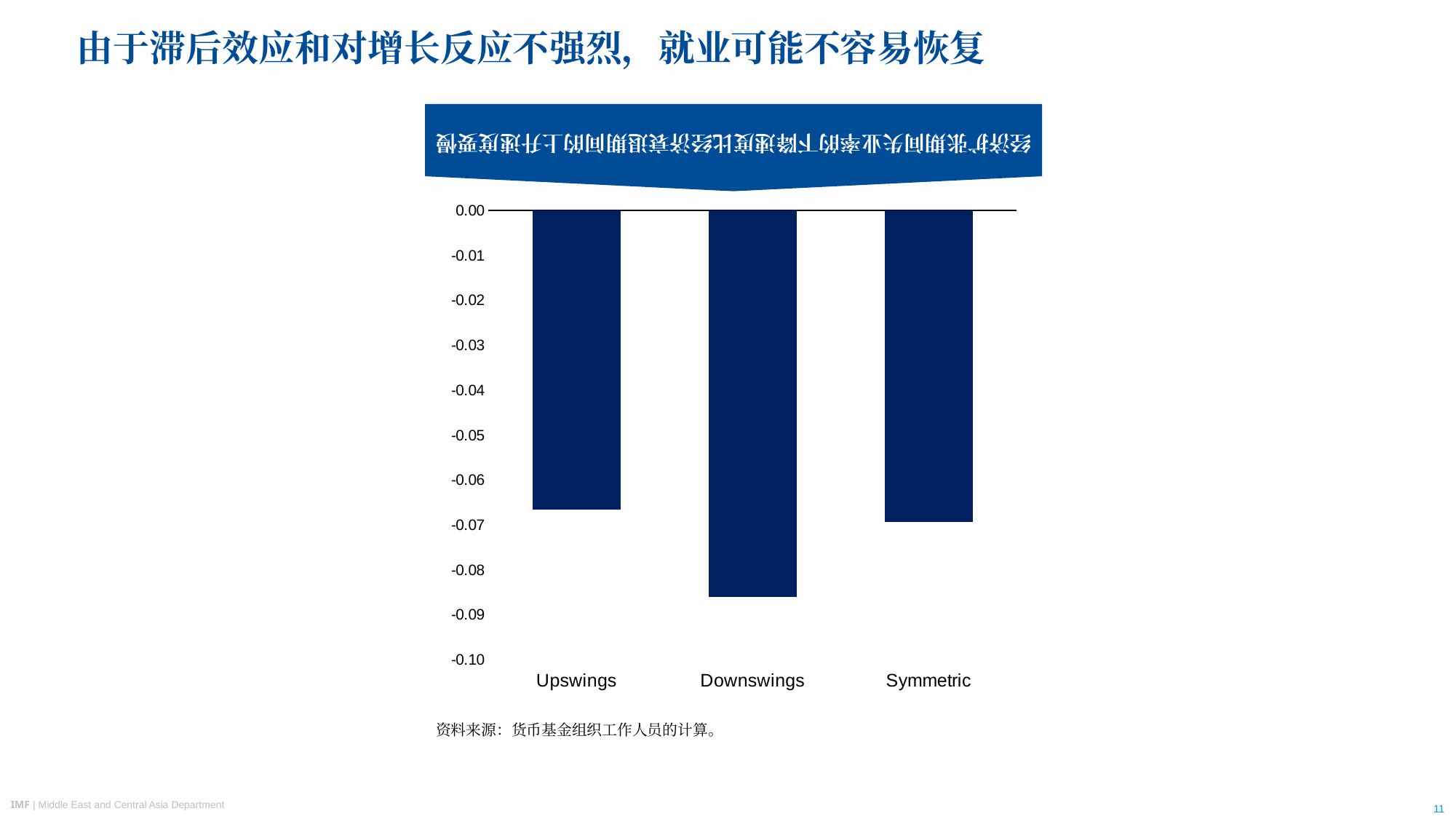
Is the value for Symmetric greater or less than -0.08? greater Which is lower, the value for Upswings or the value for Downswings? Downswings Is the value for Upswings greater or less than -0.07? greater Which is lower, the value for Symmetric or the value for Downswings? Downswings Is the value for Downswings greater or less than -0.08? less How many categories are shown on the x axis of the chart? 3 What is the lowest tick value shown on the vertical axis of the chart? -0.10 Which category has the lowest (most negative) value in the chart? Downswings What colour are the bars in the chart? Dark navy blue What kind of chart is shown on the slide? Bar chart